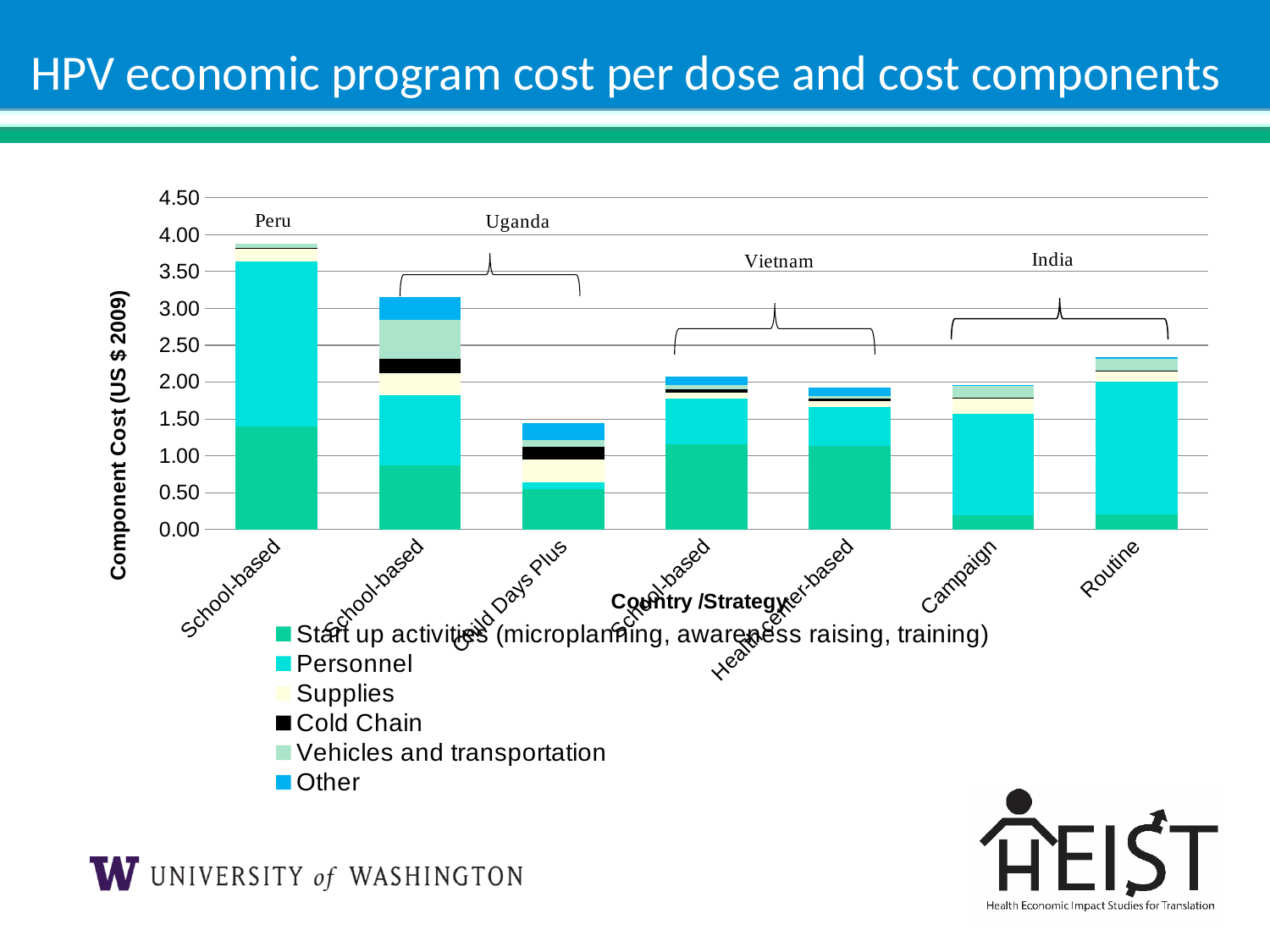
Is the total cost per dose for Uganda School-based greater or less than 2.50? greater What is the label of the vertical axis? Component Cost (US $ 2009) Which country/strategy has the highest total component cost per dose? Peru School-based Which country/strategy has the lowest total component cost per dose? Uganda Child Days Plus How many bars (country/strategy categories) are plotted in the chart? 7 Is the total cost per dose for India Routine greater or less than 2.00? greater How many cost component series does the legend list? 6 Which has a larger total cost per dose: India Campaign or India Routine? India Routine Which colour represents Cold Chain in the legend? Black Is the total cost per dose for Uganda Child Days Plus greater or less than 2.00? less What kind of chart is shown on the slide? Stacked bar chart